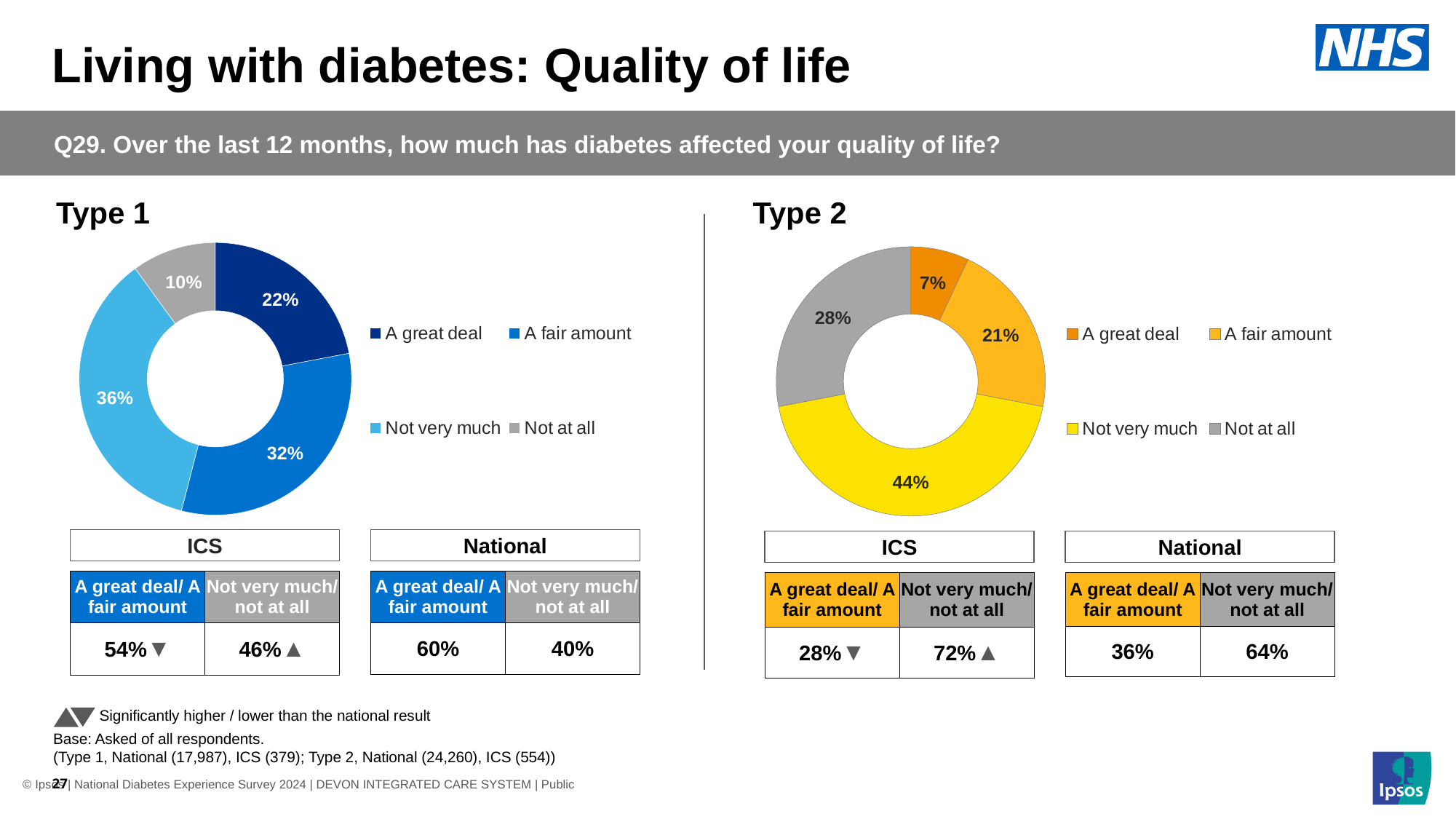
In the Type 1 chart, what percentage is shown for 'A fair amount'? 32% How many entries does the legend of the Type 1 chart list? 4 In the Type 1 chart, what is the difference between the 'Not very much' and 'A great deal' percentages? 14% In the Type 2 chart, what is the combined share of 'A great deal' and 'A fair amount'? 28% In the Type 2 chart, what percentage is shown for 'Not very much'? 44% In the Type 2 chart, which is larger: 'Not at all' or 'A fair amount'? Not at all How many categories does the Type 1 chart show? 4 In the Type 1 chart, what percentage is shown for 'Not at all'? 10% What kind of chart is used for Type 2? Doughnut chart In the Type 2 chart, which category has the smallest share? A great deal In the Type 1 chart, which category has the largest share? Not very much In the Type 2 chart, what percentage is shown for 'A great deal'? 7%